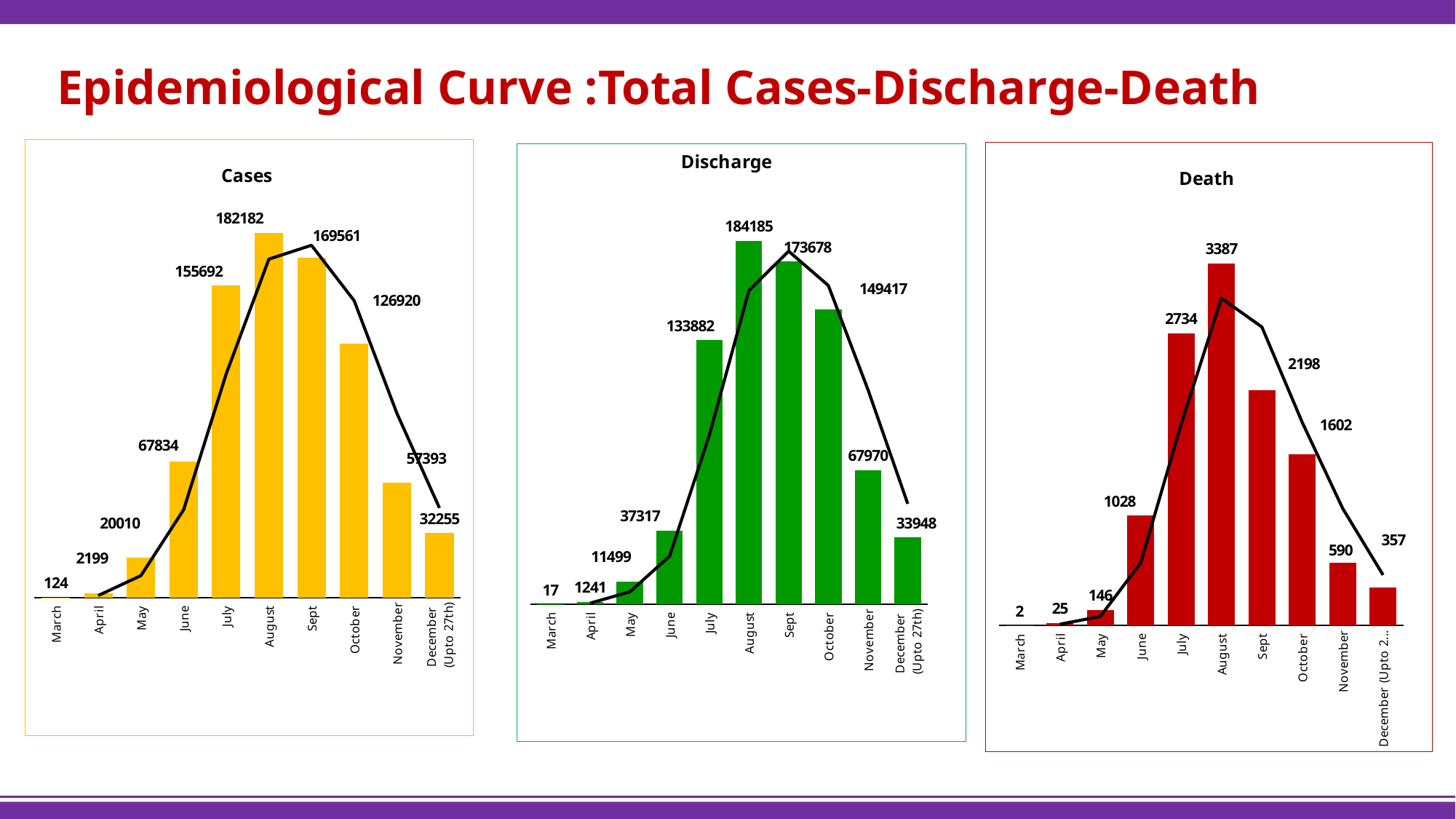
In the Death chart, what is the value for July? 2734 In the Discharge chart, what is the value for October? 149417 What is the title of the middle chart on the slide? Discharge In the Cases chart, do the values rise or fall from August to December? Fall In the Discharge chart, which is larger, the value for July or the value for October? October In the Cases chart, what is the difference between the August and Sept values? 12621 How many months are shown on the x axis of the Cases chart? 10 In the Death chart, which month has the highest value? August What kind of chart is the Death chart? Bar chart with a line overlay In the Cases chart, what is the value for August? 182182 In the Death chart, what is the difference between the Sept and October values? 596 In the Discharge chart, which month has the lowest value? March